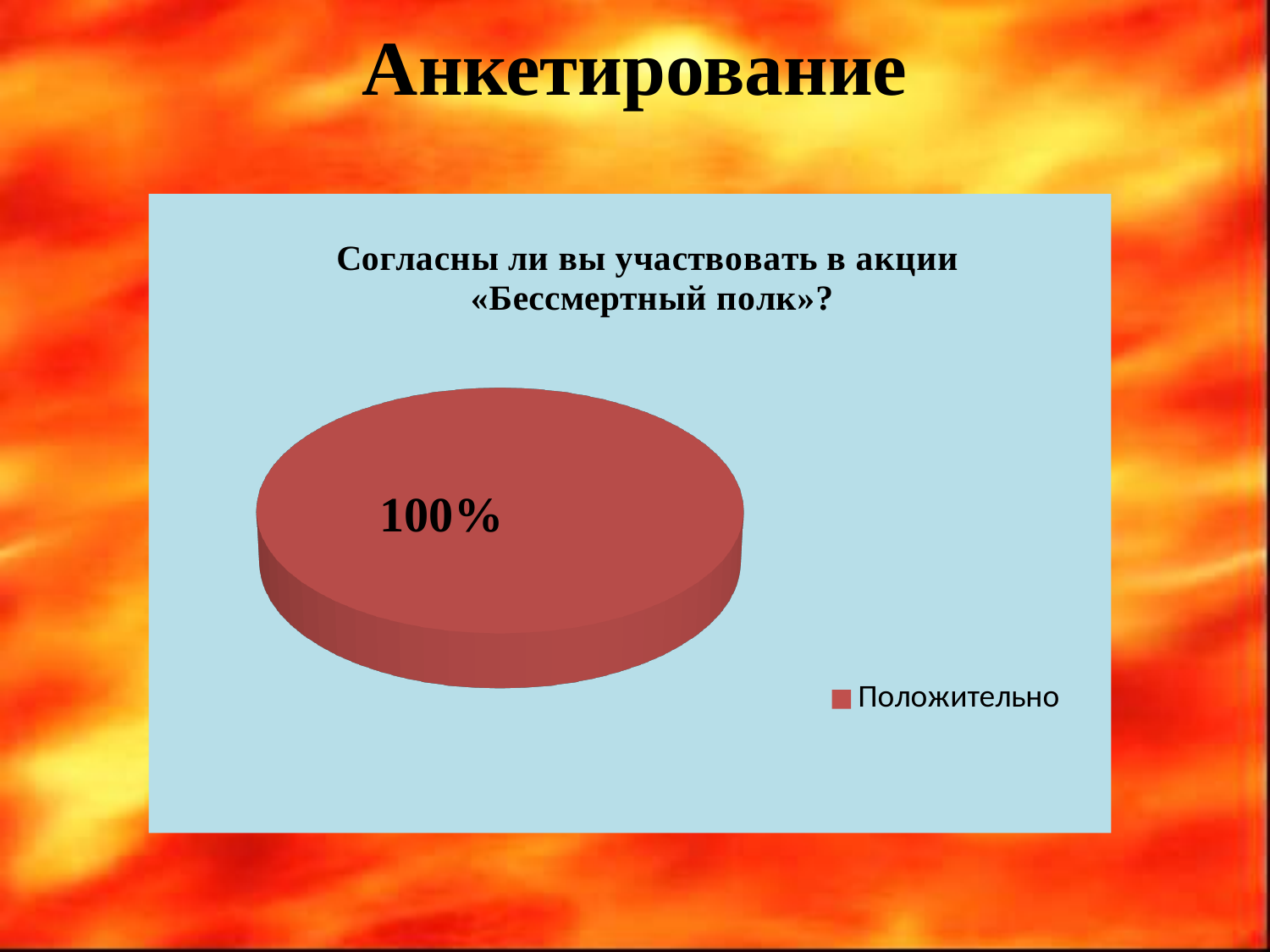
What share of the pie does the "Положительно" slice take? 100% How many slices does the pie chart have? 1 What is the label of the only legend entry? Положительно What kind of chart is shown on the slide? pie chart What is the title of the chart? Согласны ли вы участвовать в акции «Бессмертный полк»? What value is printed on the pie slice? 100% How many entries does the legend list? 1